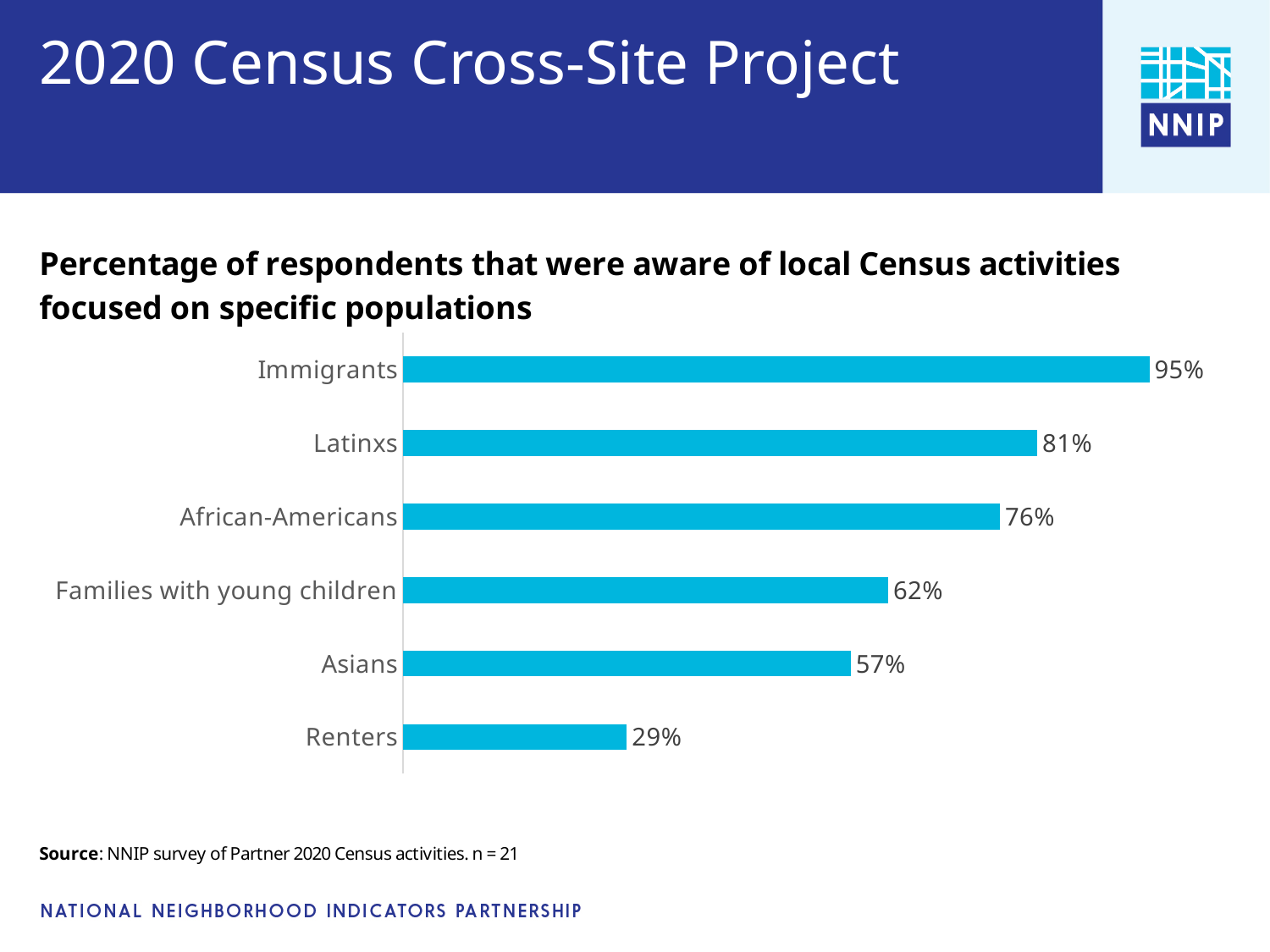
What percentage of respondents were aware of local Census activities focused on Immigrants? 95% What is the value shown for Asians? 57% What is the difference between the percentages for Immigrants and Renters? 66% What is the difference between the percentages for Latinxs and African-Americans? 5% Which population has the highest percentage of respondents aware of local Census activities? Immigrants What percentage of respondents were aware of local Census activities focused on Renters? 29% Which population has the lowest percentage of respondents aware of local Census activities? Renters What type of chart is shown on the slide? Bar chart How many population categories are shown in the chart? 6 What is the value shown for Families with young children? 62% Which has a higher percentage, Families with young children or Asians? Families with young children According to the source note, what is the sample size (n) for the survey? 21